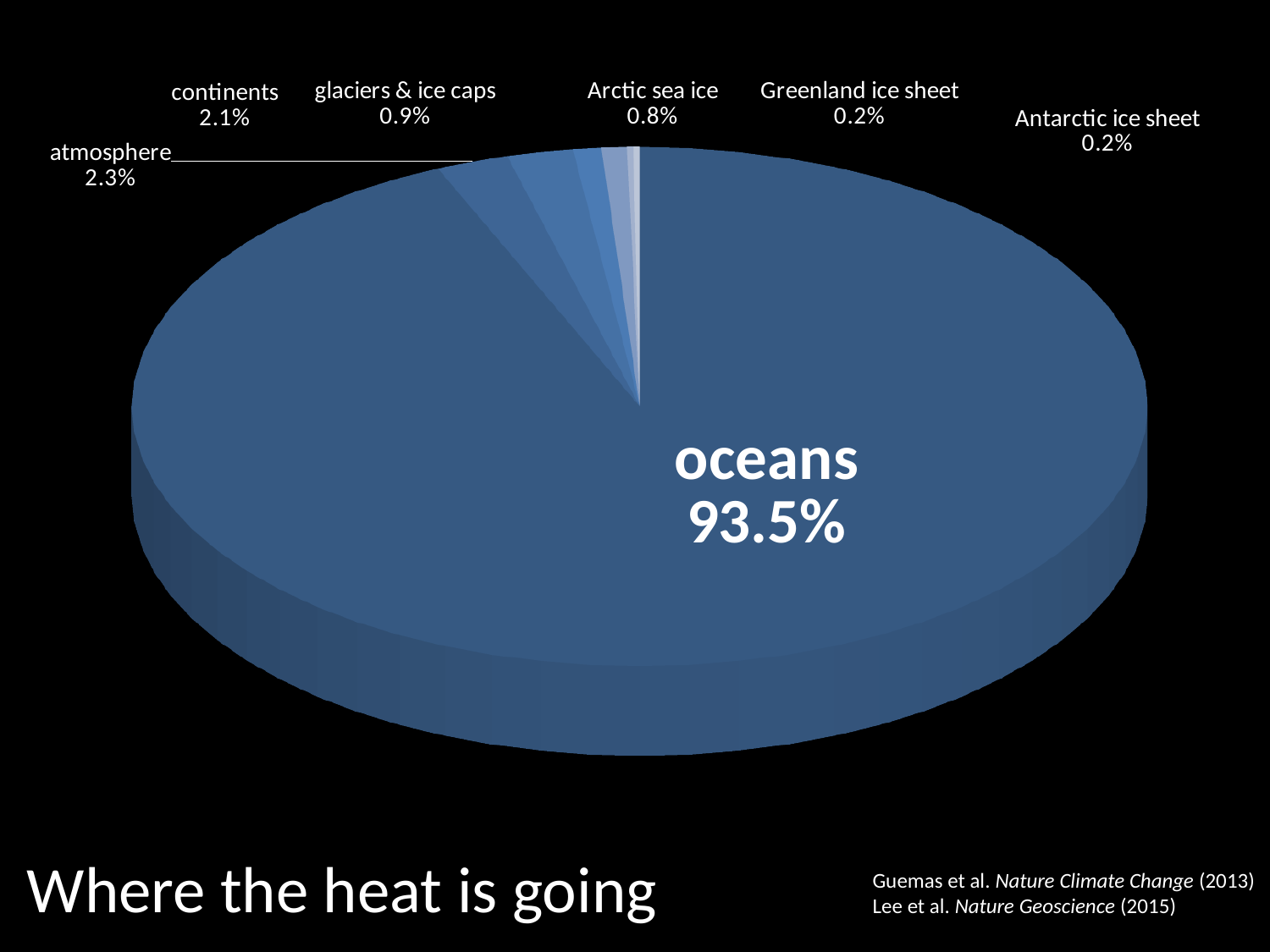
What share of the heat goes to the Greenland ice sheet? 0.2% What share of the heat goes to glaciers & ice caps? 0.9% What share of the heat goes to the continents? 2.1% Which category receives the largest share of the heat? oceans Which receives a larger share of the heat, glaciers & ice caps or Arctic sea ice? glaciers & ice caps How many categories are shown in the pie chart? 7 What share of the heat goes to the atmosphere? 2.3% What is the title of the slide? Where the heat is going What share of the heat goes to the oceans? 93.5% What is the difference between the shares for the atmosphere and the continents? 0.2% What kind of chart is shown on the slide? pie chart What share of the heat goes to Arctic sea ice? 0.8%